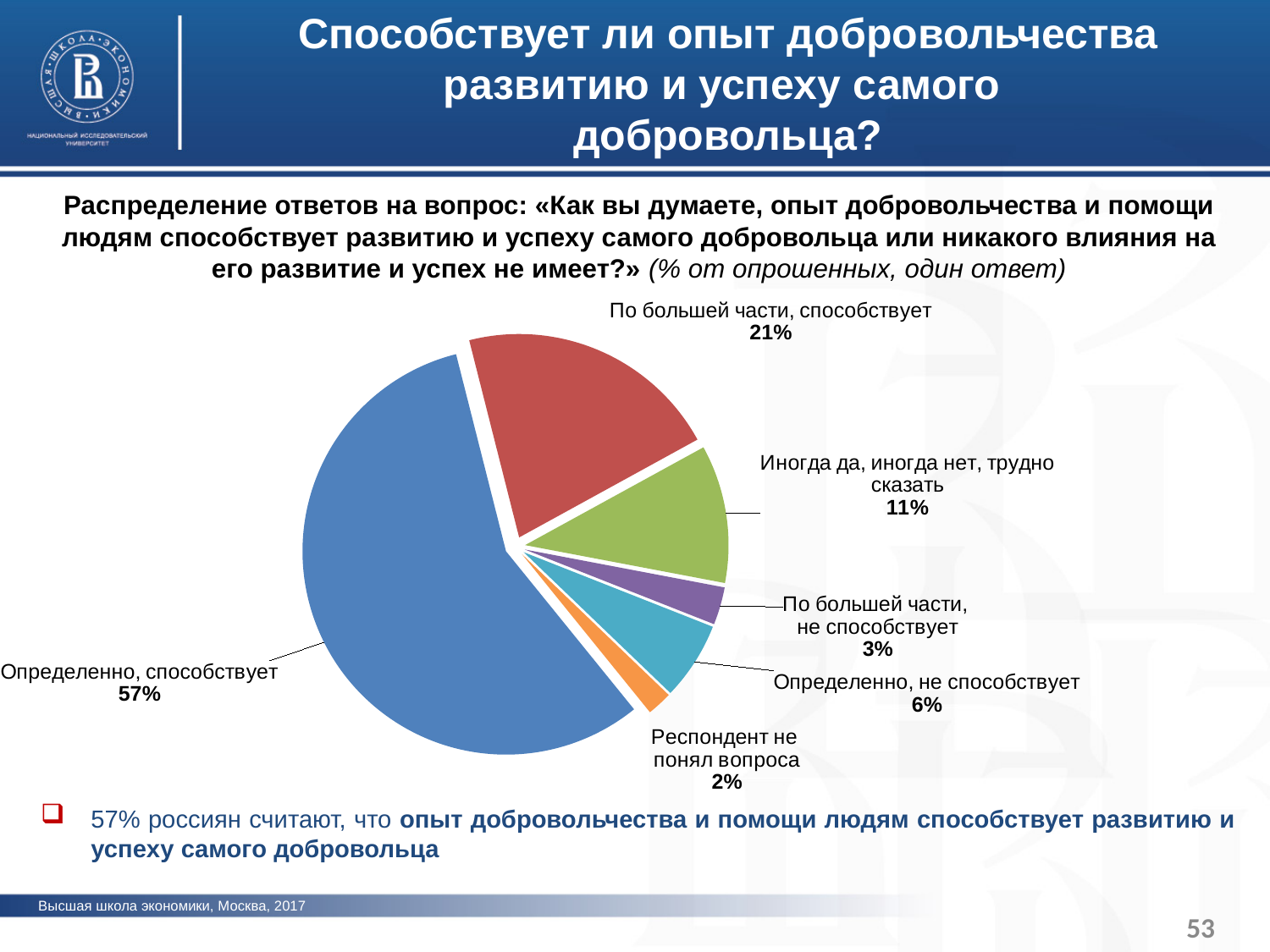
Which answer option has the largest slice of the pie? Определенно, способствует How many slices does the pie chart have? 6 Which is larger: the share for «Иногда да, иногда нет, трудно сказать» or the share for «Определенно, не способствует»? Иногда да, иногда нет, трудно сказать Which answer option has the smallest slice of the pie? Респондент не понял вопроса What share of respondents is labelled «Респондент не понял вопроса»? 2% What share of respondents answered «Определенно, не способствует»? 6% What share of respondents answered «Определенно, способствует»? 57% What kind of chart is shown on the slide? pie chart What is the difference in percentage points between «Определенно, способствует» and «По большей части, способствует»? 36 What share of respondents answered «По большей части, способствует»? 21% What share of respondents answered «Иногда да, иногда нет, трудно сказать»? 11% What share of respondents answered «По большей части, не способствует»? 3%